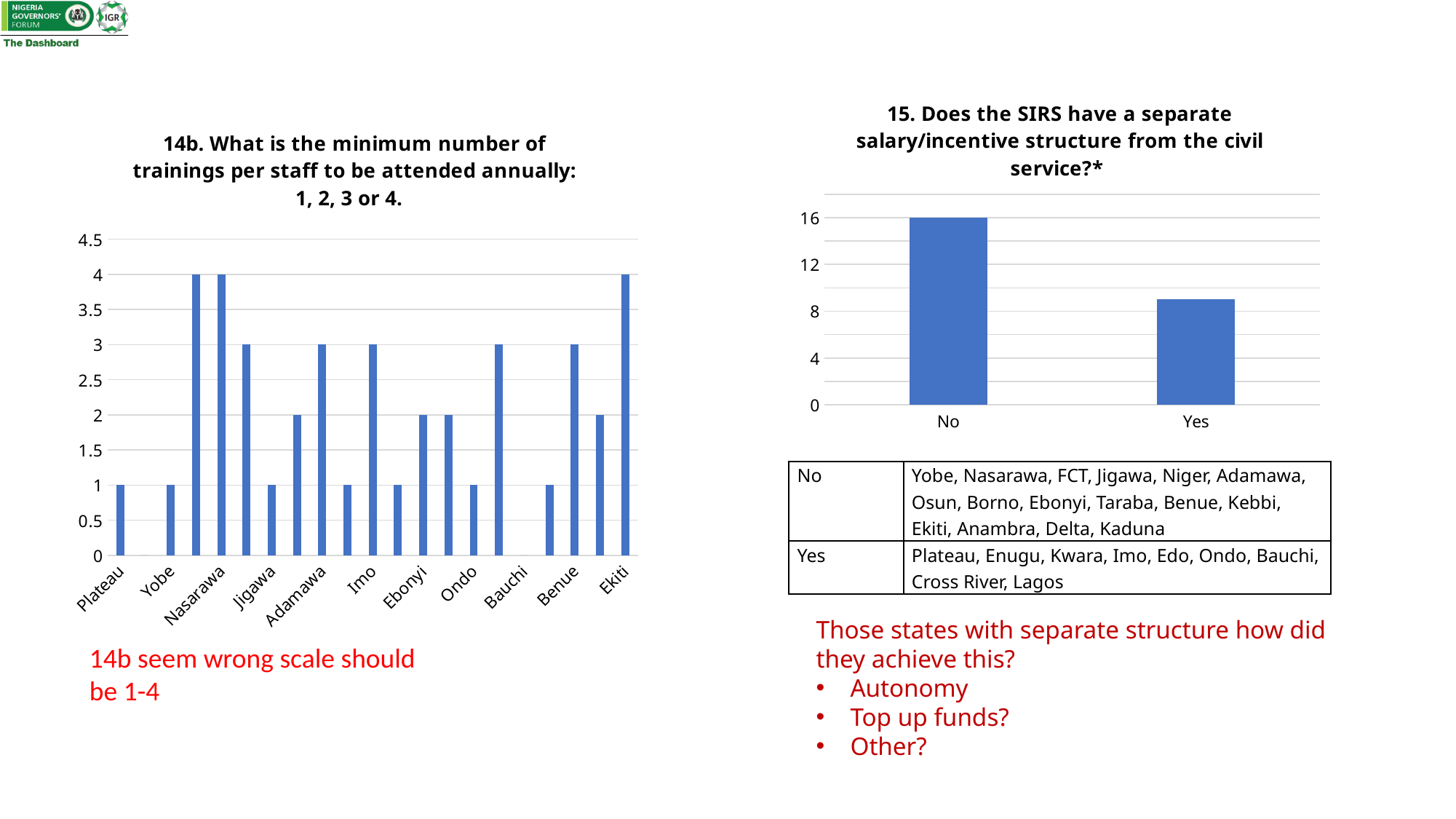
In the chart titled "14b. What is the minimum number of trainings per staff to be attended annually", what is the value for Ekiti? 4 In the chart titled "15. Does the SIRS have a separate salary/incentive structure from the civil service?*", which category has the higher value, No or Yes? No In the chart titled "14b. What is the minimum number of trainings per staff to be attended annually", what is the value for Nasarawa? 4 In the chart titled "14b. What is the minimum number of trainings per staff to be attended annually", what is the value for Plateau? 1 In the chart titled "14b. What is the minimum number of trainings per staff to be attended annually", what is the value for Ebonyi? 2 How many categories are shown in the chart titled "15. Does the SIRS have a separate salary/incentive structure from the civil service?*"? 2 What kind of chart is the chart on the left of the slide (question 14b)? Bar chart In the chart titled "14b. What is the minimum number of trainings per staff to be attended annually", which has the higher value, Plateau or Ekiti? Ekiti In the chart titled "15. Does the SIRS have a separate salary/incentive structure from the civil service?*", is the value for Yes greater or less than 8? greater In the chart titled "15. Does the SIRS have a separate salary/incentive structure from the civil service?*", is the value for Yes greater or less than 12? less In the chart titled "15. Does the SIRS have a separate salary/incentive structure from the civil service?*", what is the value for No? 16 What kind of chart is the chart on the right of the slide (question 15)? Bar chart